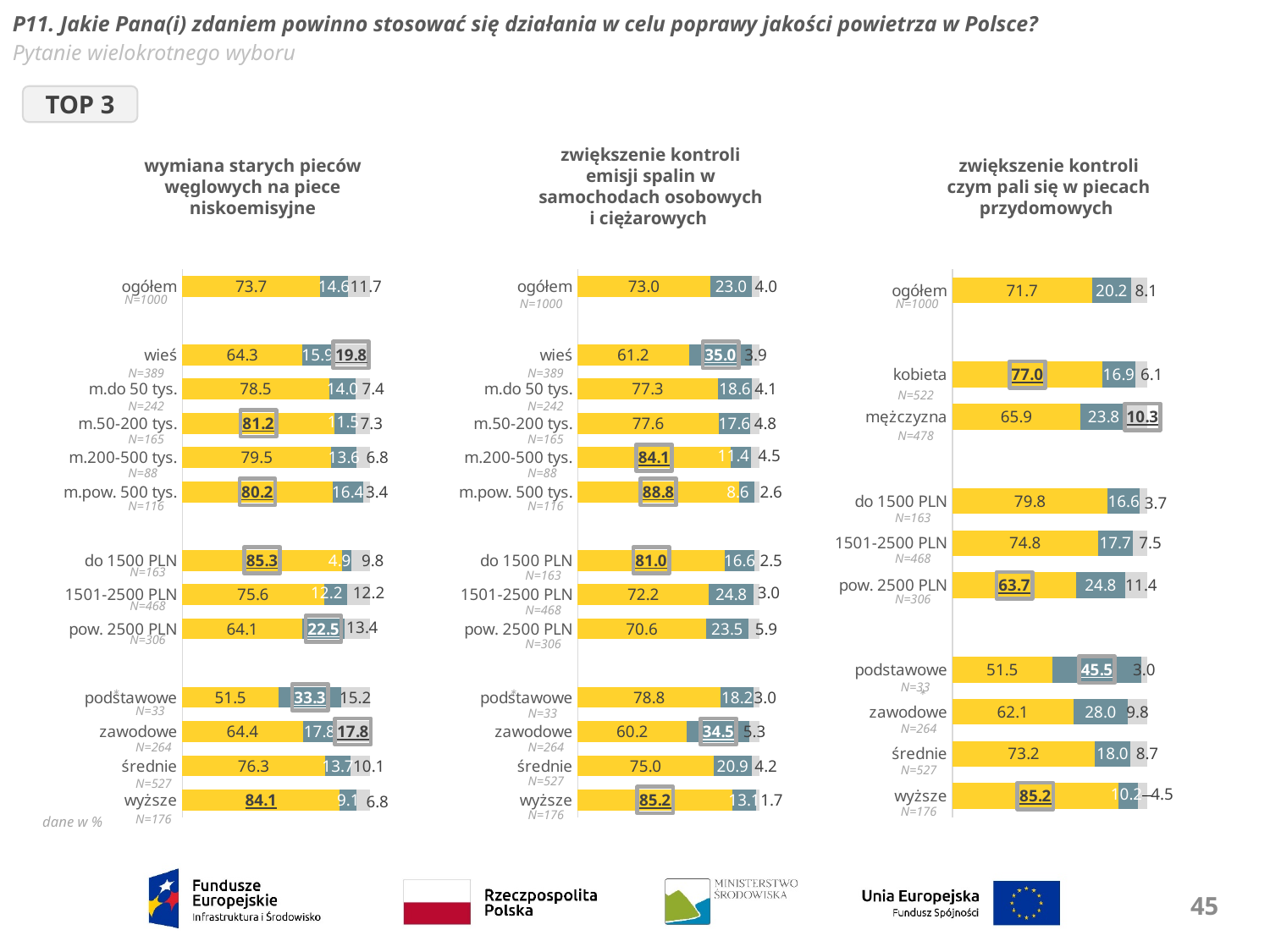
In the chart titled 'zwiększenie kontroli czym pali się w piecach przydomowych', which category has the lowest yellow segment value? podstawowe In the chart titled 'wymiana starych pieców węglowych na piece niskoemisyjne', what is the value of the yellow segment for 'ogółem'? 73.7 In the chart titled 'zwiększenie kontroli czym pali się w piecach przydomowych', what is the value of the teal segment for 'podstawowe'? 45.5 In the chart titled 'zwiększenie kontroli emisji spalin w samochodach osobowych i ciężarowych', what is the difference between the yellow segment values for 'wyższe' and 'zawodowe'? 25.0 In the chart titled 'wymiana starych pieców węglowych na piece niskoemisyjne', which category has the highest yellow segment value? do 1500 PLN In the chart titled 'zwiększenie kontroli czym pali się w piecach przydomowych', what is the sample size (N) shown for 'mężczyzna'? N=478 In the chart titled 'wymiana starych pieców węglowych na piece niskoemisyjne', what is the total of the three segments for 'wieś'? 100.0 In the chart titled 'wymiana starych pieców węglowych na piece niskoemisyjne', how many categories are shown? 13 In the chart titled 'zwiększenie kontroli czym pali się w piecach przydomowych', how many categories are shown? 10 What type of chart is used for 'zwiększenie kontroli emisji spalin w samochodach osobowych i ciężarowych'? Stacked bar chart In the chart titled 'zwiększenie kontroli czym pali się w piecach przydomowych', which has a larger yellow segment value: 'kobieta' or 'mężczyzna'? kobieta In the chart titled 'zwiększenie kontroli emisji spalin w samochodach osobowych i ciężarowych', what is the value of the yellow segment for 'm.pow. 500 tys.'? 88.8